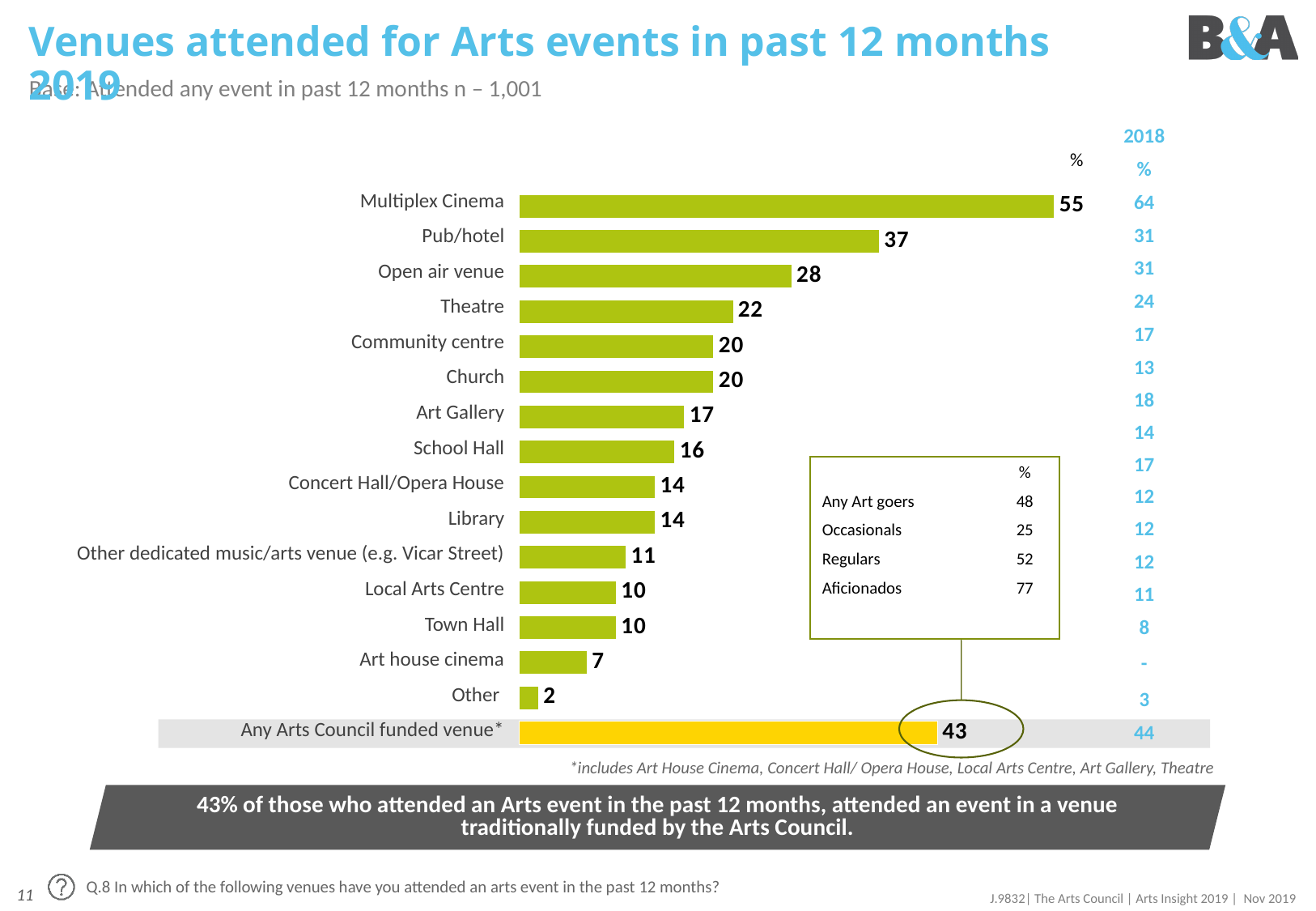
What kind of chart is shown on the slide? Bar chart What is the value for Any Arts Council funded venue*? 43 What is the difference between the values for Theatre and Art Gallery? 5 What is the value for Art house cinema? 7 Which bar is coloured yellow rather than green? Any Arts Council funded venue* What is the difference between the values for Multiplex Cinema and Pub/hotel? 18 What is the value for Multiplex Cinema? 55 Which venue has the lowest value? Other How many venue categories are plotted as bars in the chart? 16 Which is larger, the value for Open air venue or the value for Theatre? Open air venue Which venue has the highest value? Multiplex Cinema What is the value for Pub/hotel? 37